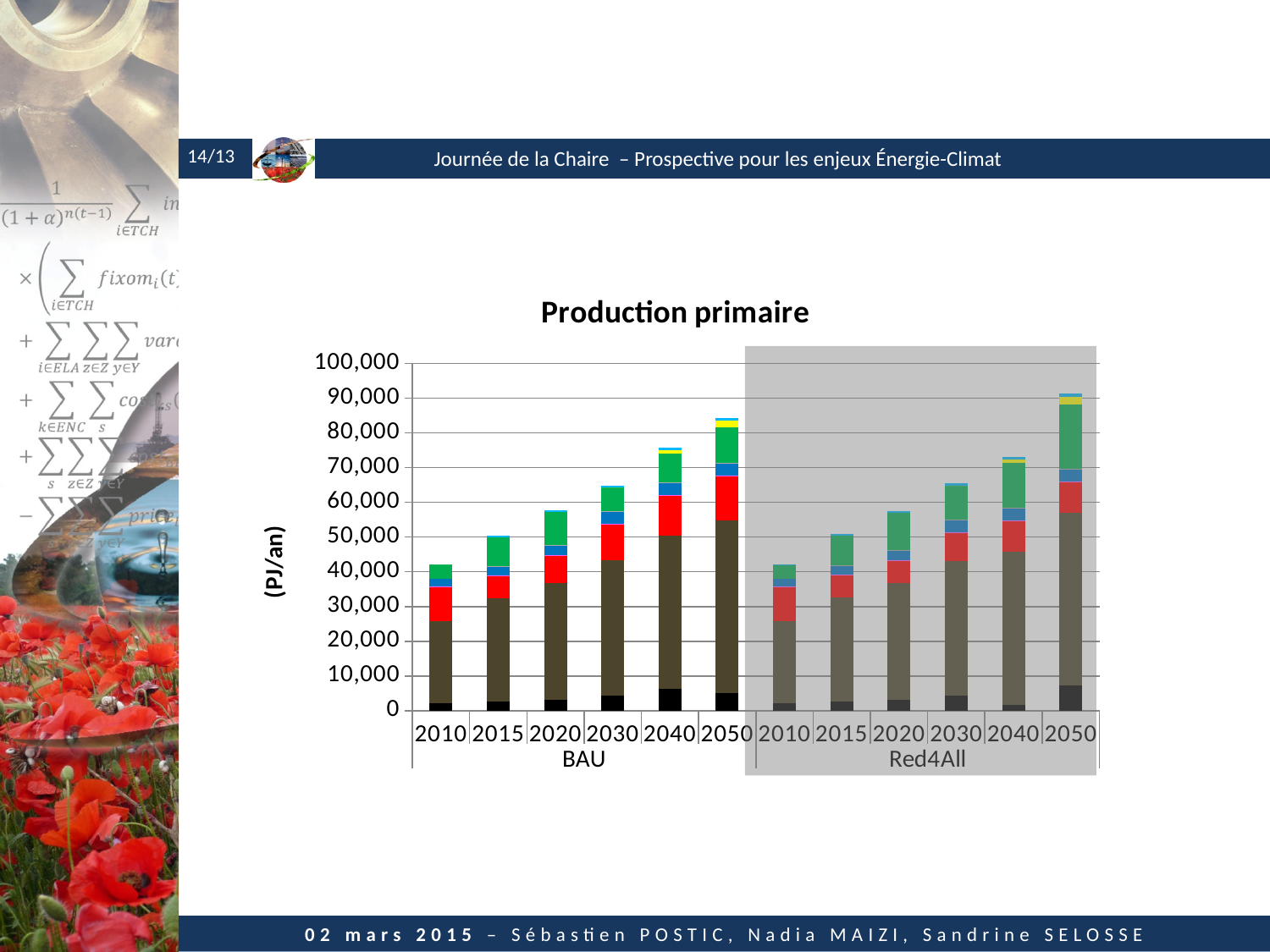
How many years are shown for the BAU scenario? 6 What kind of chart is shown on the slide? Stacked bar chart Which bar has the highest total in the chart? Red4All 2050 What is the title of the chart? Production primaire Is the total for Red4All 2030 greater or less than 60,000? greater Is the total for Red4All 2050 greater or less than 80,000? greater Is the total for BAU 2010 greater or less than 50,000? less How many bars are plotted in the chart in total? 12 Do the bar totals rise or fall from 2010 to 2050 within the Red4All scenario? rise What unit is shown on the y-axis label of the chart? (PJ/an) Which is larger, the total for BAU 2050 or the total for Red4All 2050? Red4All 2050